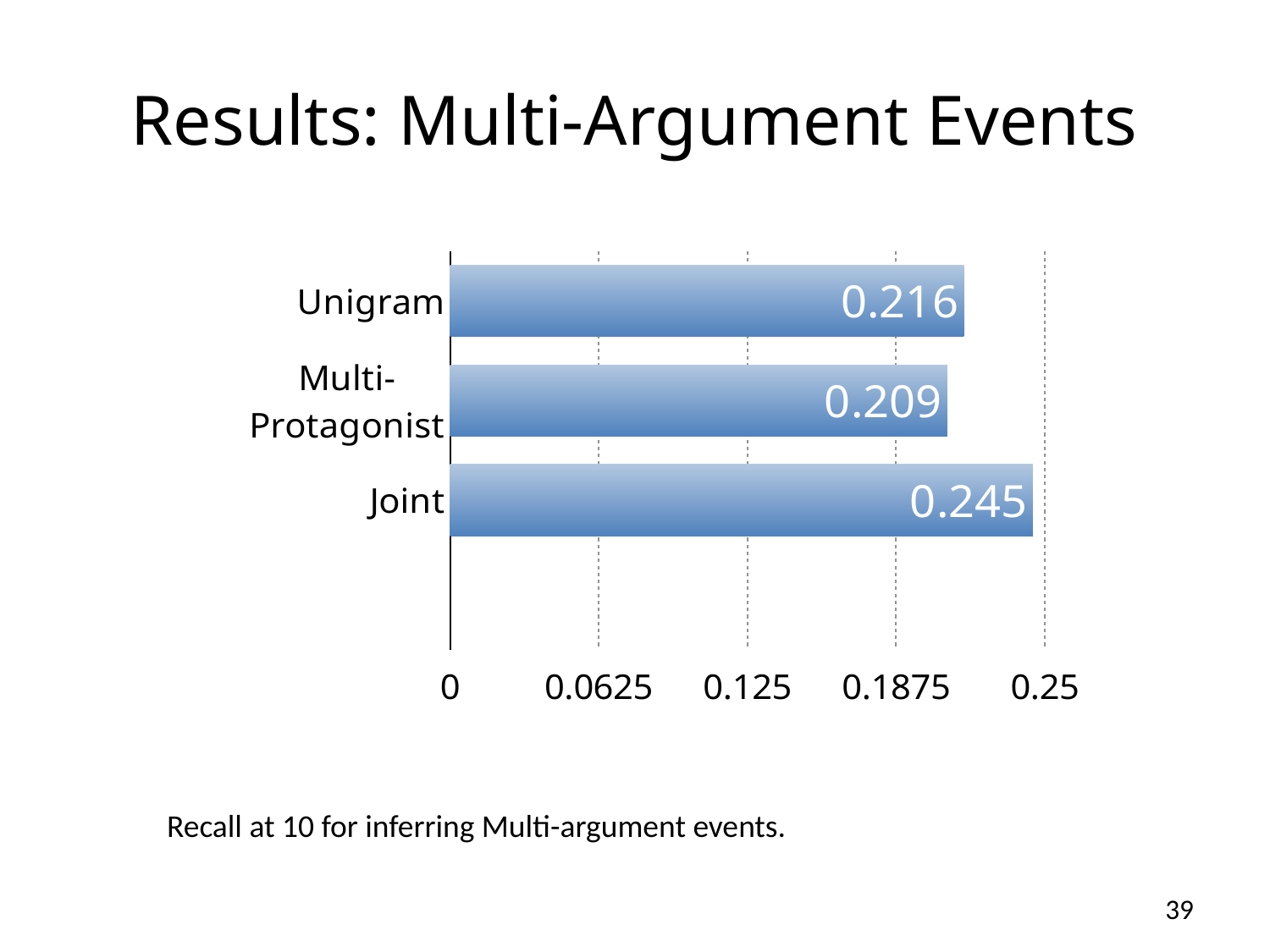
Which is larger, the value for Joint or the value for Multi-Protagonist? Joint What is the difference between the values for Unigram and Multi-Protagonist? 0.007 Which category has the lowest value? Multi-Protagonist What is the value for Multi-Protagonist? 0.209 How many categories are shown in the chart? 3 Is the value for Joint greater or less than 0.1875? greater Which category has the highest value? Joint What is the title of the slide containing the chart? Results: Multi-Argument Events What kind of chart is shown on the slide? bar chart What is the value for Joint? 0.245 What is the value for Unigram? 0.216 What is the difference between the values for Joint and Unigram? 0.029